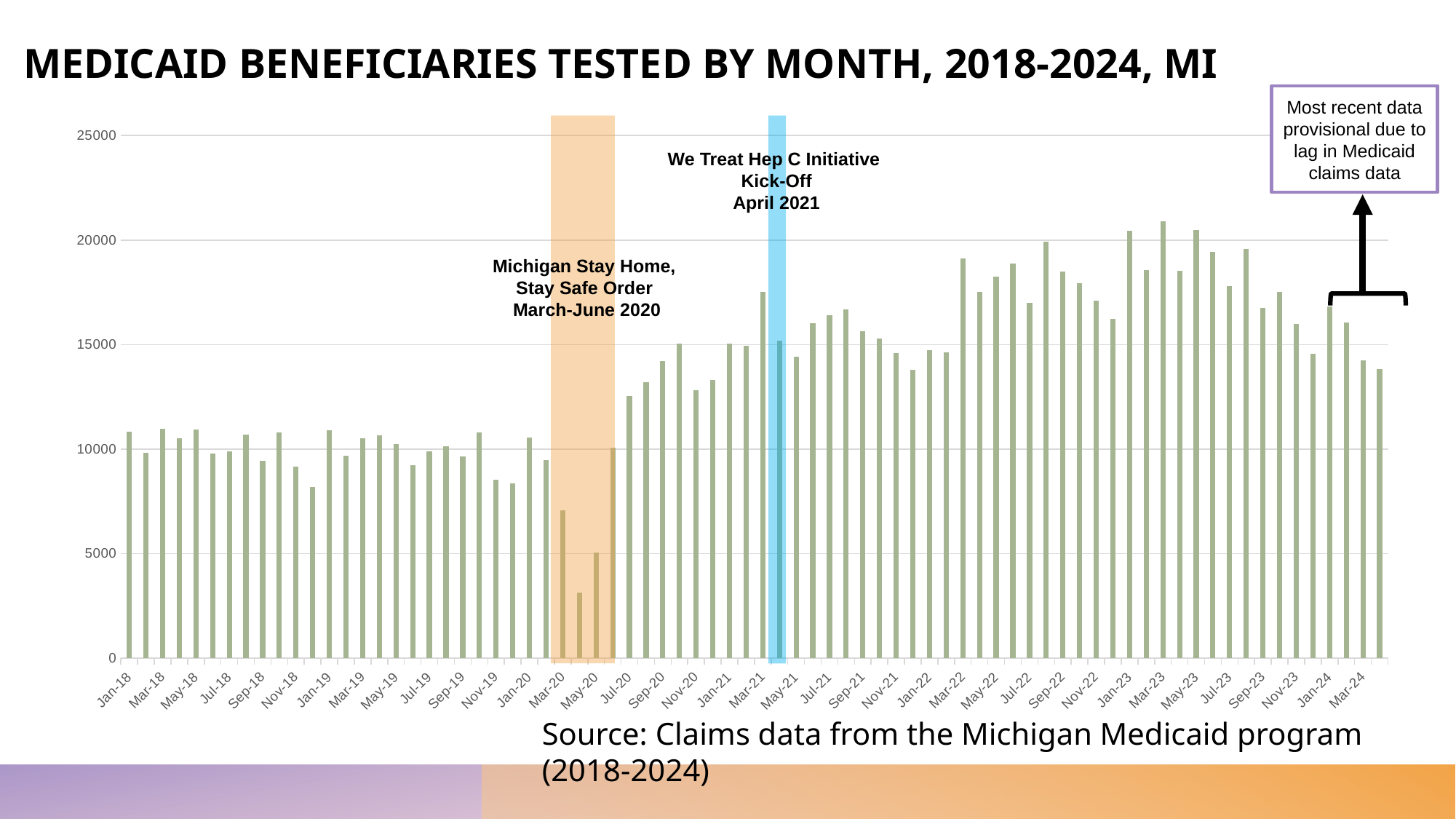
Is the value for Mar-23 greater or less than 20000? greater Is the value for Mar-21 greater or less than 15000? greater Do the values generally rise or fall from Jul-20 to Mar-21? Rise Which month has the highest number of Medicaid beneficiaries tested? Mar-23 What is the title of the chart? MEDICAID BENEFICIARIES TESTED BY MONTH, 2018-2024, MI What kind of chart is shown on the slide? Bar chart Which event does the blue shaded band on the chart mark? We Treat Hep C Initiative Kick-Off, April 2021 Is the value for Jan-18 greater or less than 10000? greater Which is larger, the value for Mar-23 or the value for Jan-18? Mar-23 Which is larger, the value for Jan-18 or the value for Apr-20? Jan-18 Which month has the lowest number of Medicaid beneficiaries tested? Apr-20